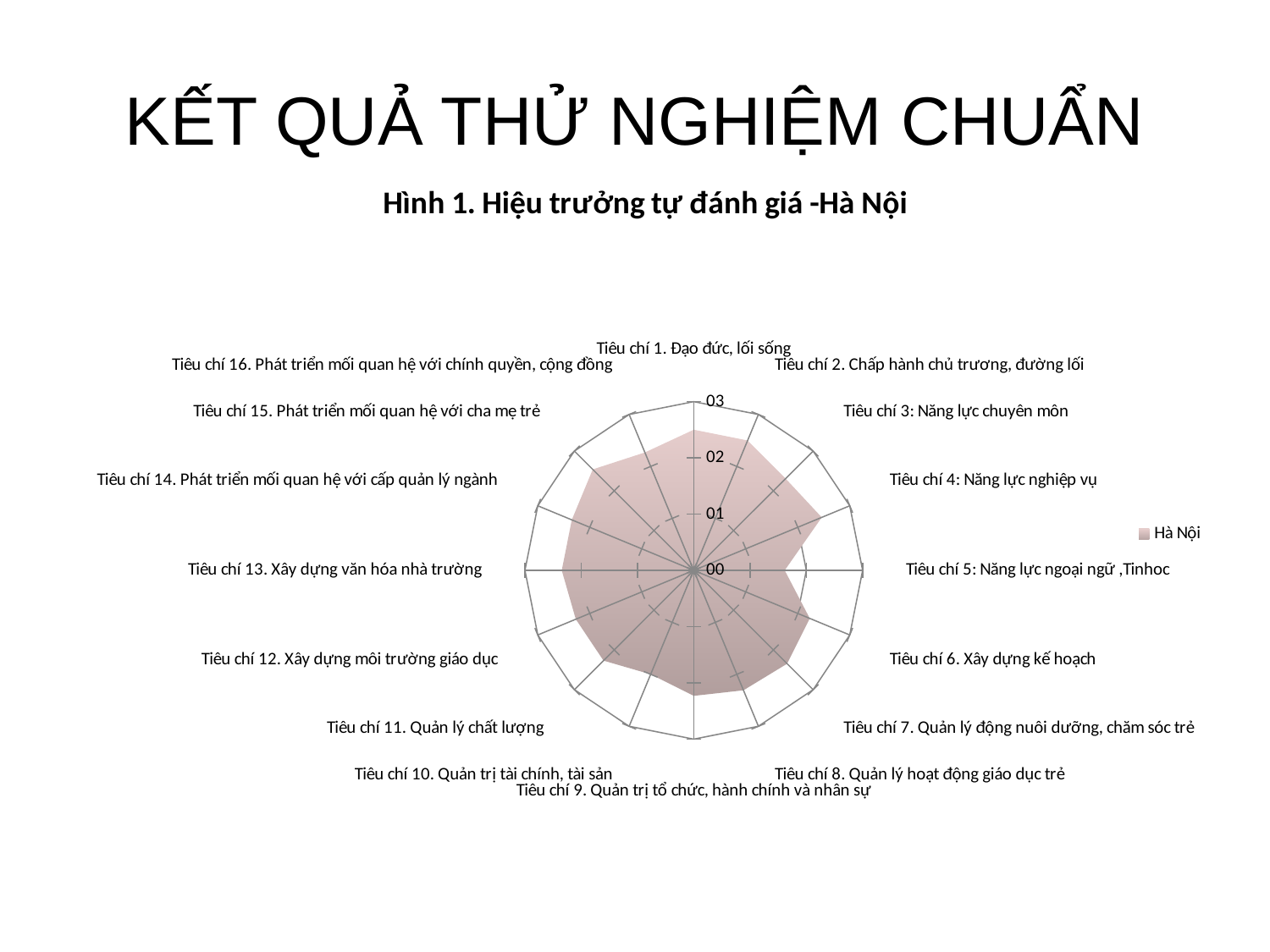
How many series does the legend list? 1 What kind of chart is shown on the slide? Radar chart Which criterion has the lowest value on the radar chart? Tiêu chí 5: Năng lực ngoại ngữ ,Tinhoc Is the value for Tiêu chí 14. Phát triển mối quan hệ với cấp quản lý ngành greater or less than 02? greater Which has the larger value: Tiêu chí 13. Xây dựng văn hóa nhà trường or Tiêu chí 5: Năng lực ngoại ngữ ,Tinhoc? Tiêu chí 13. Xây dựng văn hóa nhà trường What is the name of the series shown in the legend? Hà Nội How many criteria (categories) are plotted on the radar chart? 16 Is the value for Tiêu chí 1. Đạo đức, lối sống greater or less than 02? greater What is the title of the chart? Hình 1. Hiệu trưởng tự đánh giá -Hà Nội Is the value for Tiêu chí 13. Xây dựng văn hóa nhà trường greater or less than 02? greater Which has the larger value: Tiêu chí 1. Đạo đức, lối sống or Tiêu chí 5: Năng lực ngoại ngữ ,Tinhoc? Tiêu chí 1. Đạo đức, lối sống